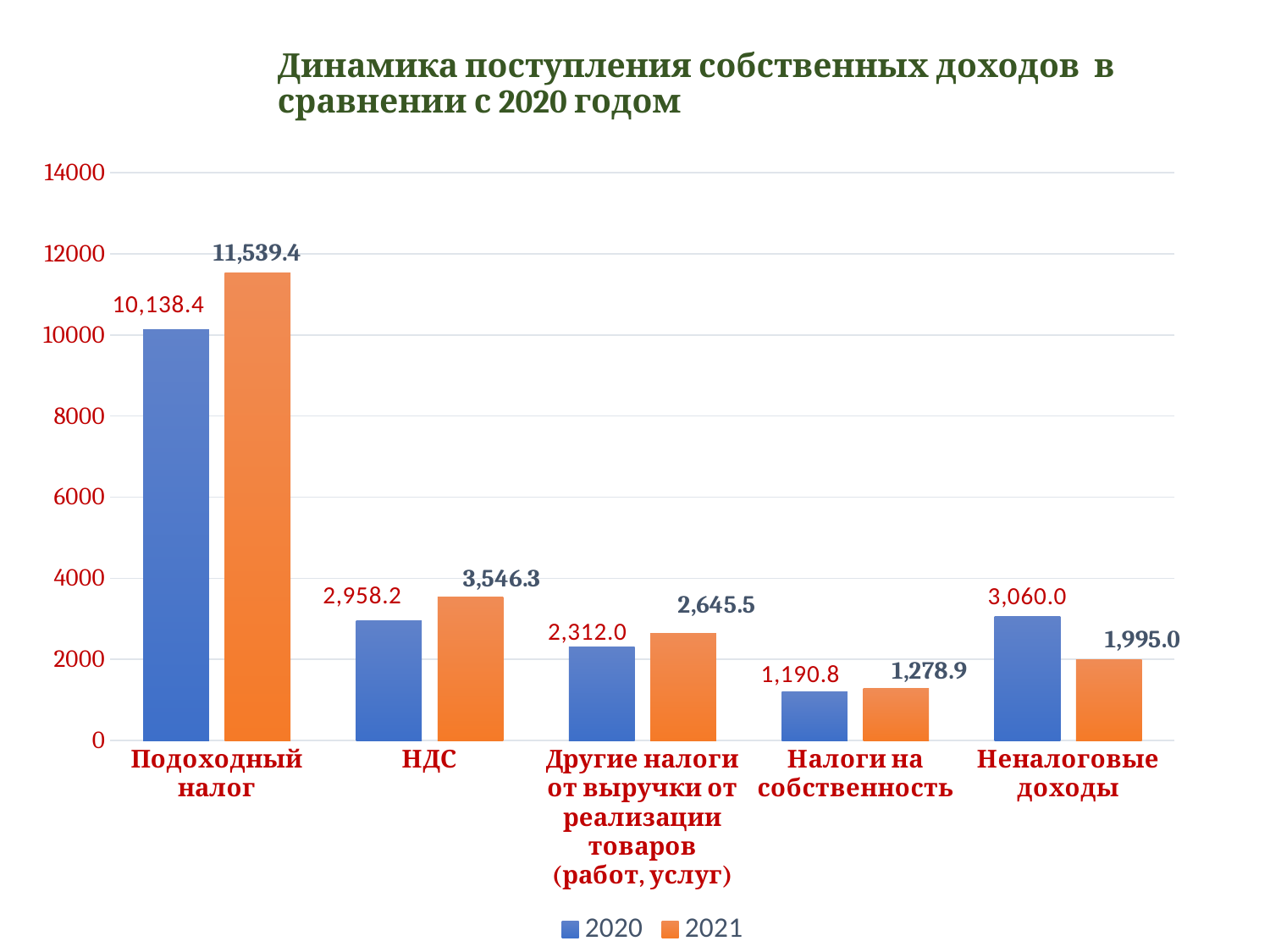
What is the 2021 value for Неналоговые доходы? 1,995.0 How many categories are shown on the x axis? 5 Which is larger for Неналоговые доходы, the 2020 value or the 2021 value? 2020 How many series does the legend list? 2 What type of chart is shown on the slide? Bar chart What is the 2021 value for Подоходный налог? 11,539.4 Which category has the highest 2021 value? Подоходный налог What is the difference between the 2020 and 2021 values for Неналоговые доходы? 1,065.0 What is the difference between the 2021 and 2020 values for Подоходный налог? 1,401.0 Which category has the lowest 2020 value? Налоги на собственность What is the 2020 value for Налоги на собственность? 1,190.8 What is the 2020 value for НДС? 2,958.2